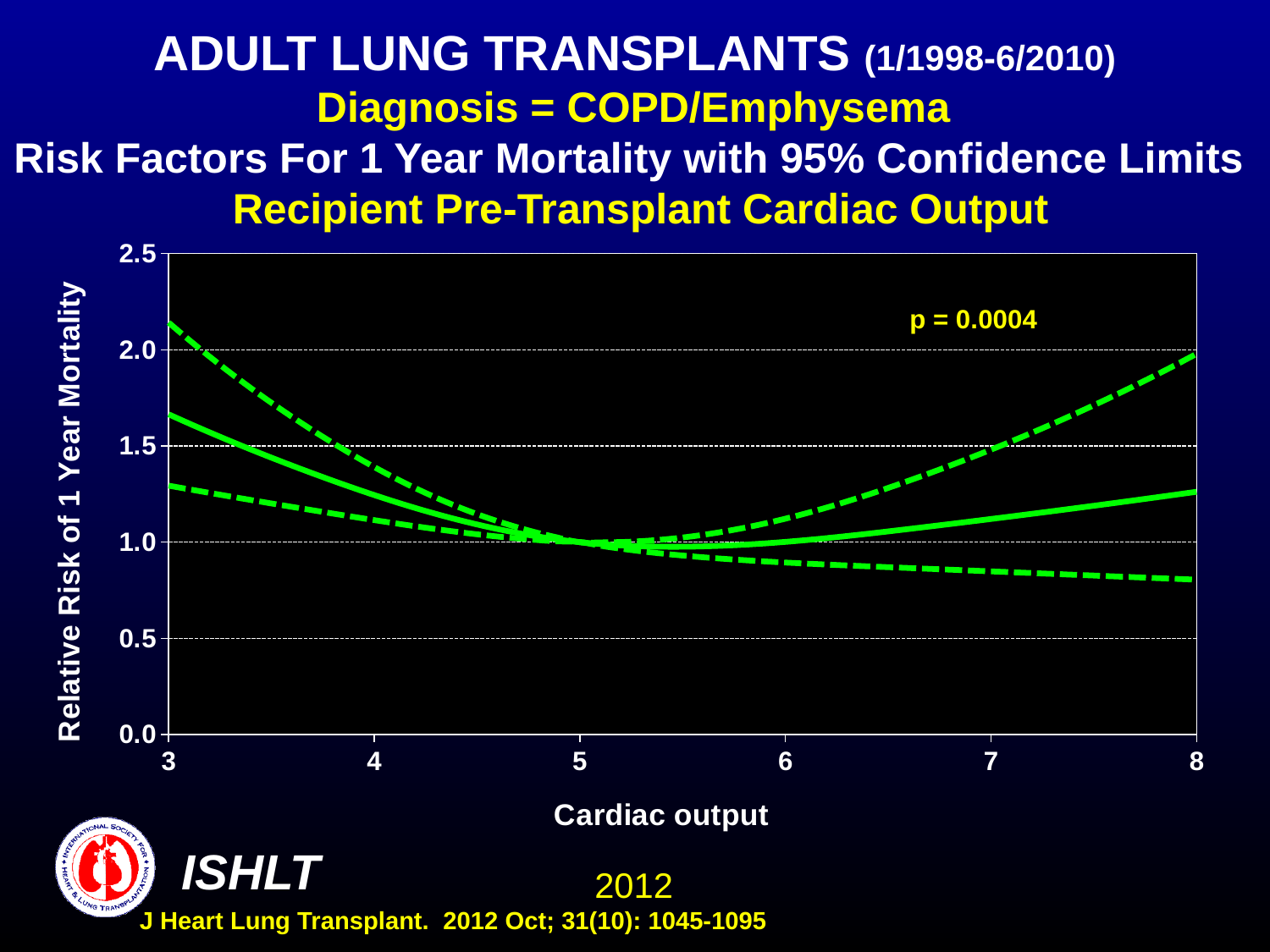
Is the value of the solid line at a cardiac output of 3 greater or less than 1.5? greater Is the value of the solid line at a cardiac output of 8 greater or less than 1.5? less Does the solid line rise or fall as cardiac output increases from 3 to 5? fall Is the value of the lower dashed line at a cardiac output of 8 greater or less than 1.0? less What kind of chart is shown on the slide? line chart What is the label of the x axis? Cardiac output Is the value of the solid line at a cardiac output of 3 larger or smaller than its value at a cardiac output of 8? larger What p-value is printed on the chart? p = 0.0004 How many lines are plotted on the chart? 3 Does the solid line rise or fall as cardiac output increases from 5 to 8? rise